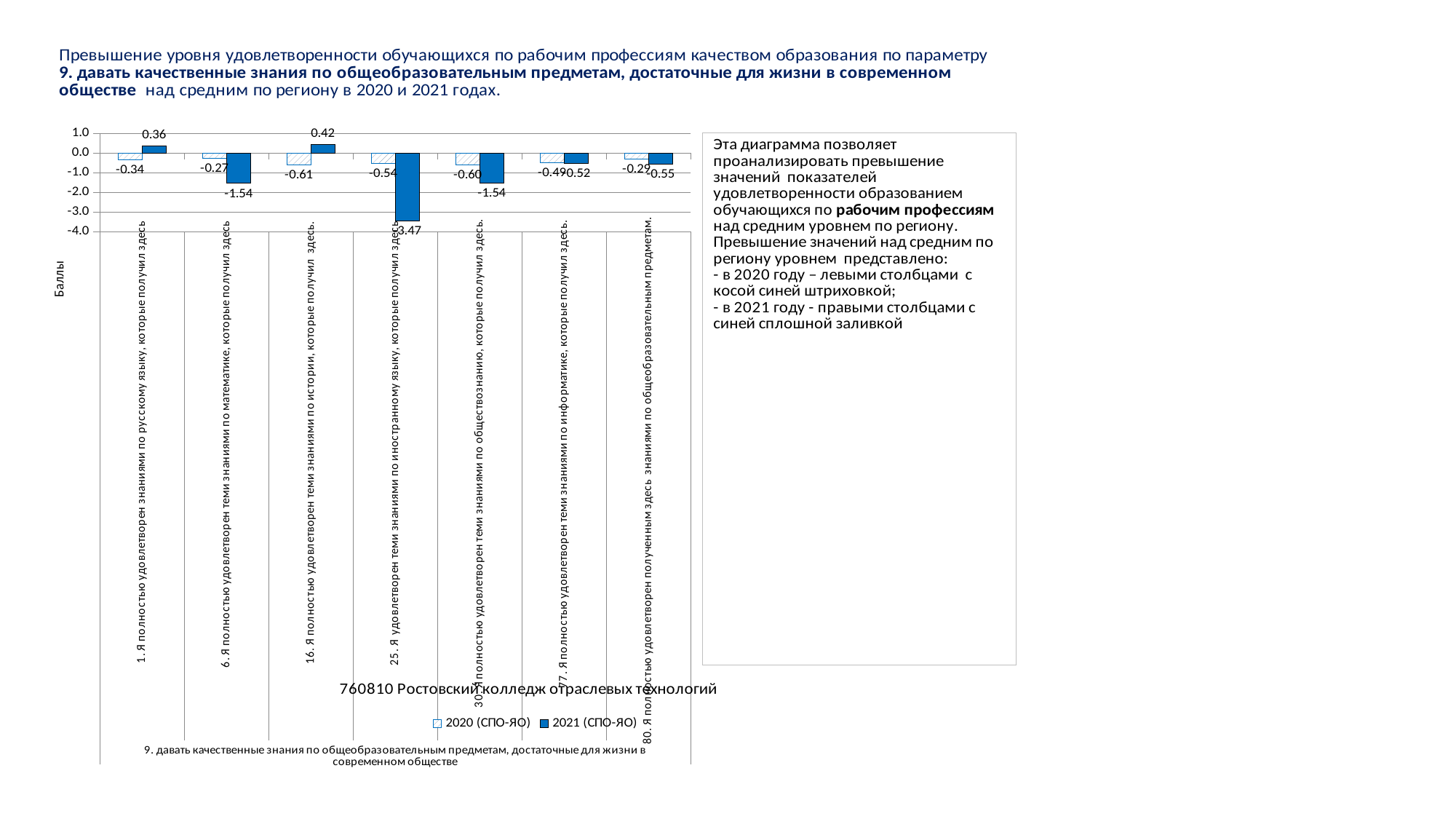
What is the 2021 (СПО-ЯО) value for the category about knowledge of Russian language (item 1)? 0.36 Which category has the highest 2021 (СПО-ЯО) value? 16. Я полностью удовлетворен теми знаниями по истории, которые получил здесь What is the 2020 (СПО-ЯО) value for the category about knowledge of informatics (item 77)? -0.49 For the category about knowledge of social studies (item 30), which is larger: the 2020 value or the 2021 value? 2020 value How many series does the chart legend list? 2 How many categories are shown on the x axis of the chart? 7 What is the difference between the 2021 and 2020 values for the category about knowledge of mathematics (item 6)? 1.27 Which category has the lowest 2021 (СПО-ЯО) value? 25. Я удовлетворен теми знаниями по иностранному языку, которые получил здесь What is the label of the vertical axis of the chart? Баллы What is the 2020 (СПО-ЯО) value for the category about knowledge of history (item 16)? -0.61 What is the 2021 (СПО-ЯО) value for the category about knowledge of a foreign language (item 25)? -3.47 What type of chart is shown on the slide? Bar chart